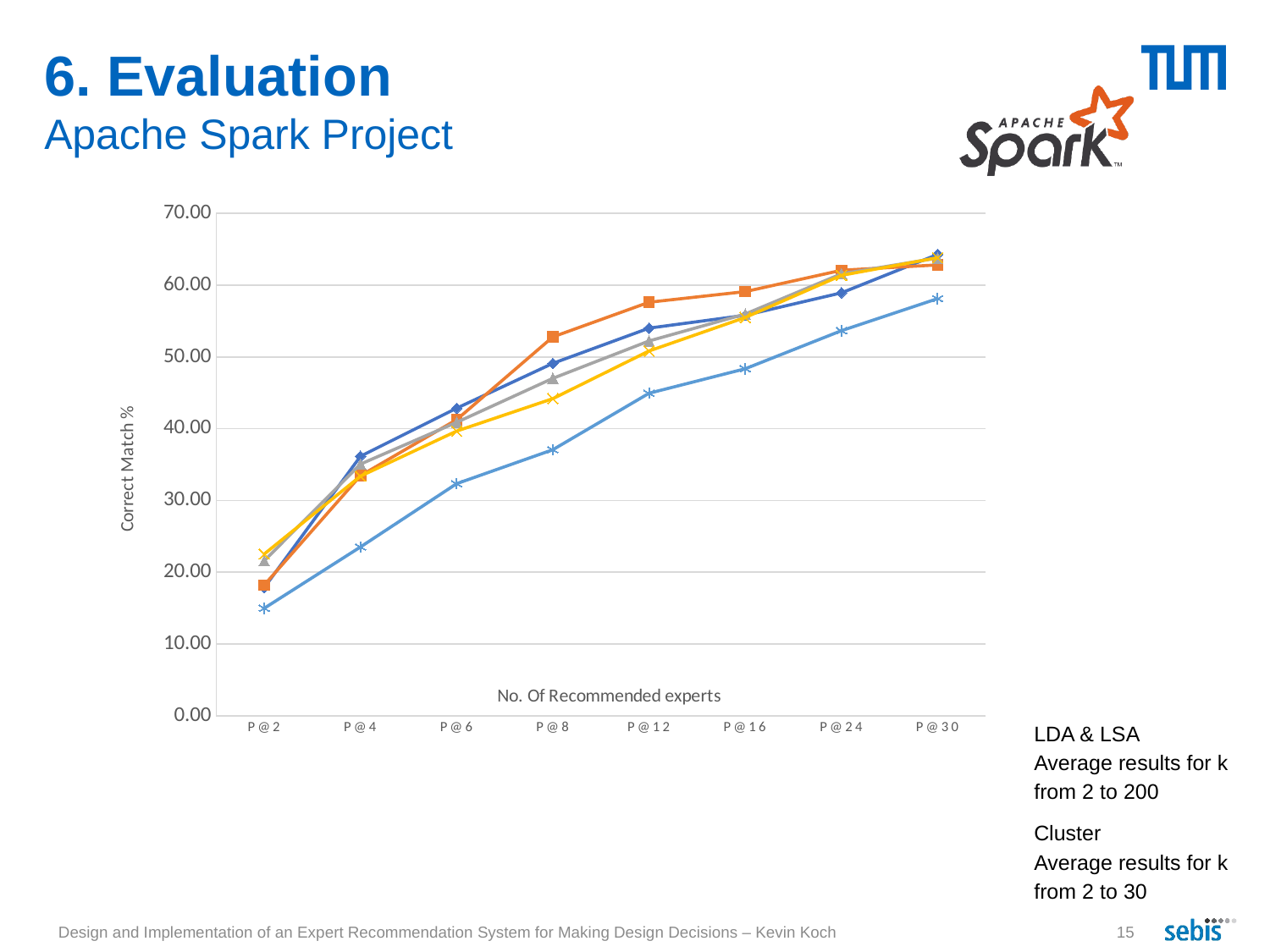
What is the title of the y axis of the chart? Correct Match % Is the value of the light blue line with asterisk markers at P @ 30 greater or less than 60.00? less How many categories are shown on the x axis of the chart? 8 Is the value of the light blue line with asterisk markers at P @ 2 greater or less than 20.00? less Which line has the lowest value at P @ 30? the light blue line with asterisk markers What is the title of the x axis of the chart? No. Of Recommended experts Is the value of the orange line with square markers at P @ 8 greater or less than 50.00? greater What kind of chart is shown on the slide? line chart At P @ 12, which is higher: the orange line with square markers or the light blue line with asterisk markers? the orange line with square markers What is the highest value shown on the y axis of the chart? 70.00 How many lines are plotted on the chart? 5 Do the values on the chart generally rise or fall from P @ 2 to P @ 30? rise